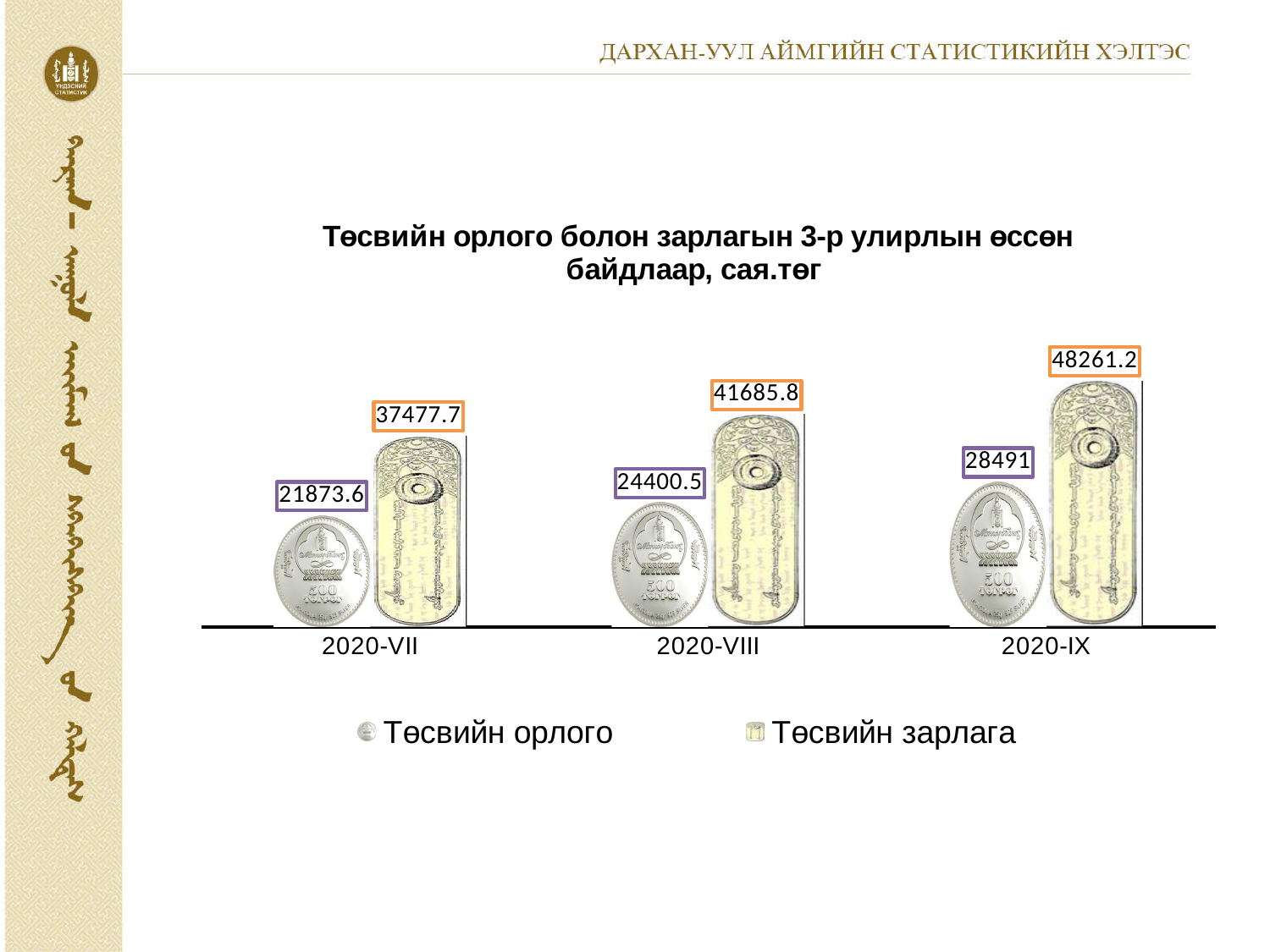
In which period is Төсвийн орлого lowest? 2020-VII By how much did Төсвийн орлого increase from 2020-VII to 2020-IX? 6617.4 How many series does the legend list? 2 Which is larger in 2020-VIII, Төсвийн орлого or Төсвийн зарлага? Төсвийн зарлага What kind of chart is shown on the slide? Bar chart What is the value of Төсвийн орлого for 2020-VII? 21873.6 What is the value of Төсвийн орлого for 2020-IX? 28491 What is the difference between Төсвийн зарлага and Төсвийн орлого in 2020-IX? 19770.2 In which period is Төсвийн зарлага highest? 2020-IX Do the values of Төсвийн зарлага rise or fall from 2020-VII to 2020-IX? Rise How many periods are shown on the x axis? 3 What is the value of Төсвийн зарлага for 2020-VIII? 41685.8